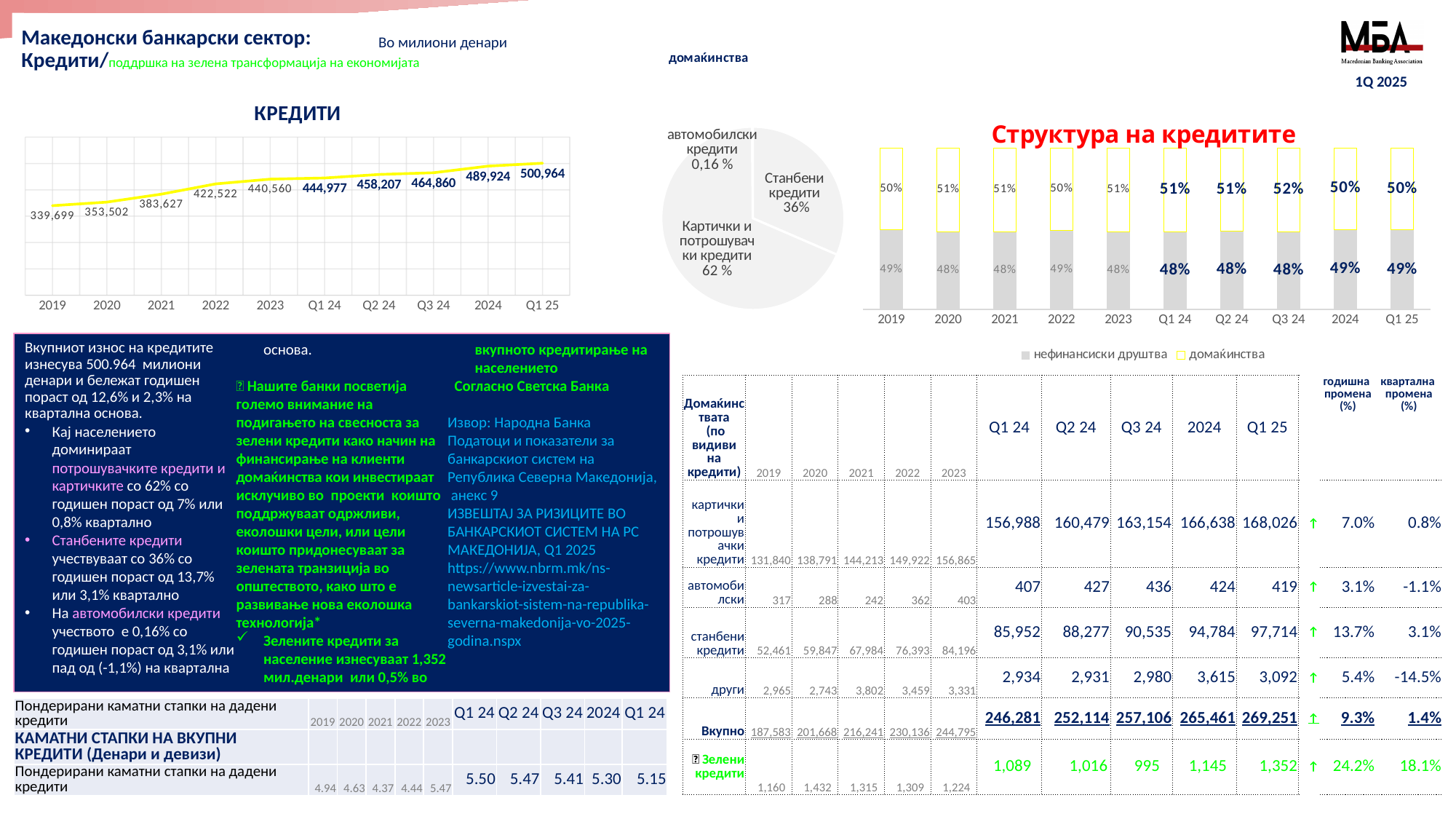
In the pie chart titled домаќинства, what share do Картички и потрошувачки кредити have? 62 % In the pie chart titled домаќинства, which category has the smallest share? автомобилски кредити In the stacked bar chart titled Структура на кредитите, what is the value for домаќинства in Q3 24? 52% In the line chart titled КРЕДИТИ, do the values rise or fall from 2019 to Q1 25? rise In the line chart titled КРЕДИТИ, what is the value for Q1 25? 500,964 In the line chart titled КРЕДИТИ, which period has the lowest value? 2019 In the pie chart titled домаќинства, what share do Станбени кредити have? 36% In the line chart titled КРЕДИТИ, how many data points are plotted? 10 In the line chart titled КРЕДИТИ, which period has the highest value? Q1 25 In the line chart titled КРЕДИТИ, what is the difference between the values for 2024 and Q3 24? 25,064 In the line chart titled КРЕДИТИ, what is the value for 2019? 339,699 In the stacked bar chart titled Структура на кредитите, how many series does the legend list? 2